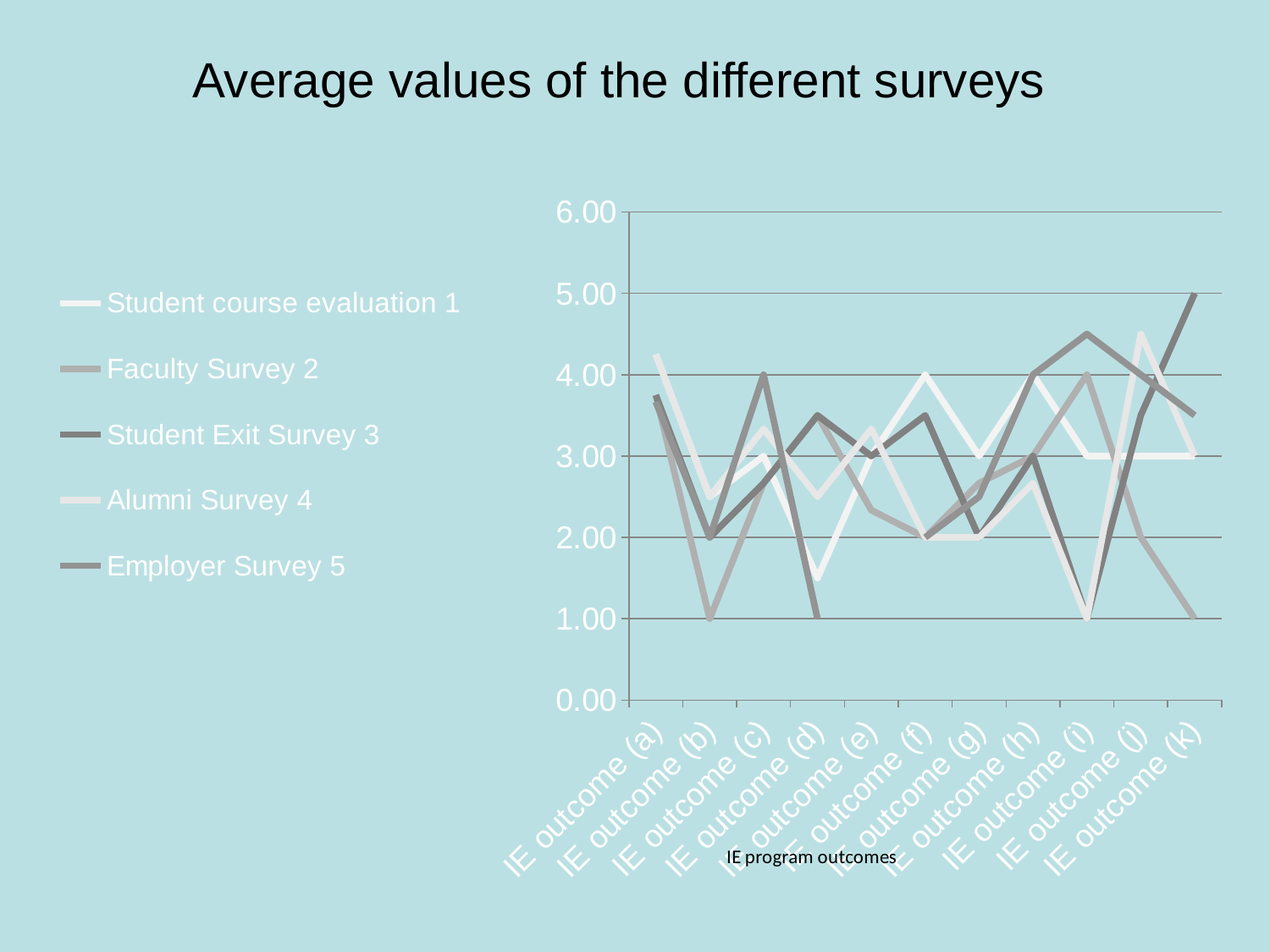
What kind of chart is shown on the slide? line chart Is the highest point plotted on the chart greater or less than 5.50? less Is the lowest point plotted on the chart greater or less than 2.00? less What is the title of the chart? Average values of the different surveys What is the label of the x axis? IE program outcomes How many series does the legend list? 5 What is the highest value shown on the y axis? 6.00 How many IE outcome categories are plotted along the x axis? 11 Is the highest point plotted on the chart greater or less than 4.00? greater At which IE outcome does the highest point on the chart occur? IE outcome (k)